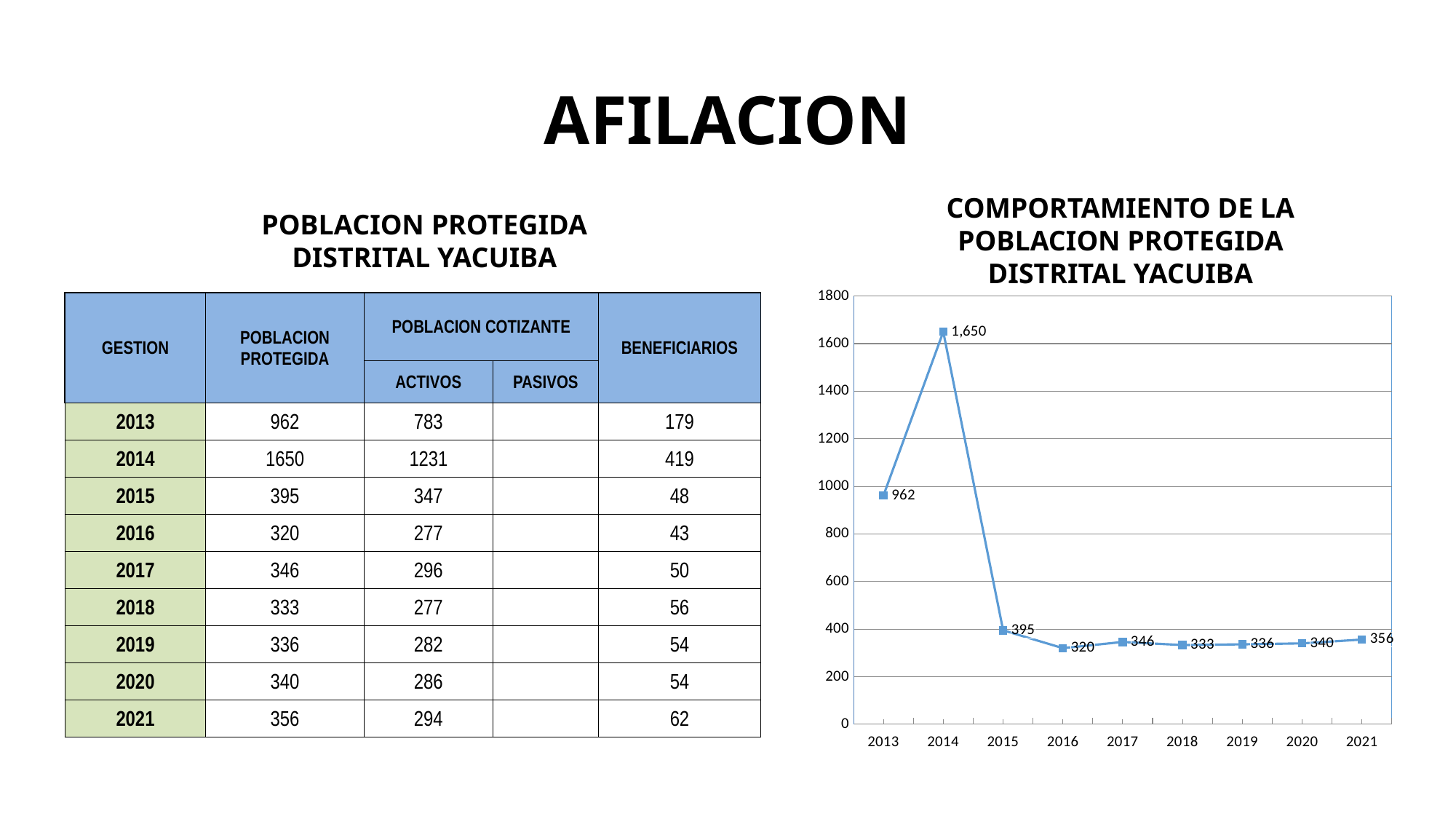
What is the value plotted for 2014? 1,650 What is the value plotted for 2021? 356 What type of chart is shown on the slide? line chart What is the difference between the values for 2014 and 2015? 1,255 Which year has the lowest value in the chart? 2016 What is the value plotted for 2013? 962 How many years are plotted on the x axis? 9 What is the title of the chart? COMPORTAMIENTO DE LA POBLACION PROTEGIDA DISTRITAL YACUIBA Which is larger, the value for 2017 or the value for 2018? 2017 Which year has the highest value in the chart? 2014 Do the values rise or fall from 2014 to 2016? fall Is the value for 2013 greater or less than 800? greater